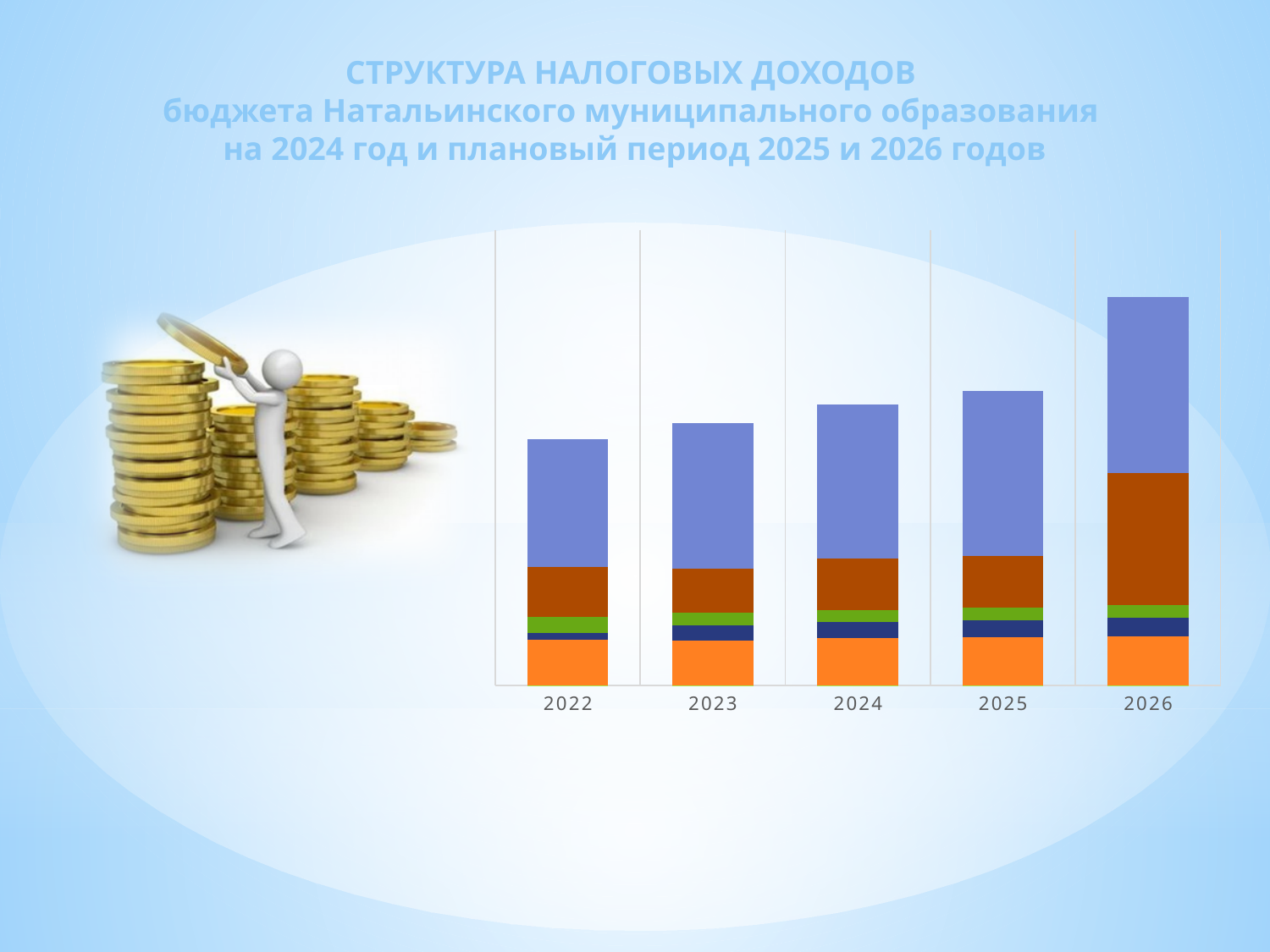
How many years are shown on the x axis of the chart? 5 Which year has the largest brown segment in its bar? 2026 Which bar is taller overall, 2022 or 2023? 2023 Do the total bar heights rise or fall from 2022 to 2026? Rise What kind of chart is shown on the slide? Stacked bar chart Which year has the tallest stacked bar in the chart? 2026 Which colour is the topmost segment of each stacked bar? Light blue How many coloured segments make up each stacked bar? 5 What is the first year shown on the x axis? 2022 Which year has the shortest stacked bar in the chart? 2022 Which bar is taller overall, 2024 or 2026? 2026 What is the last year shown on the x axis? 2026